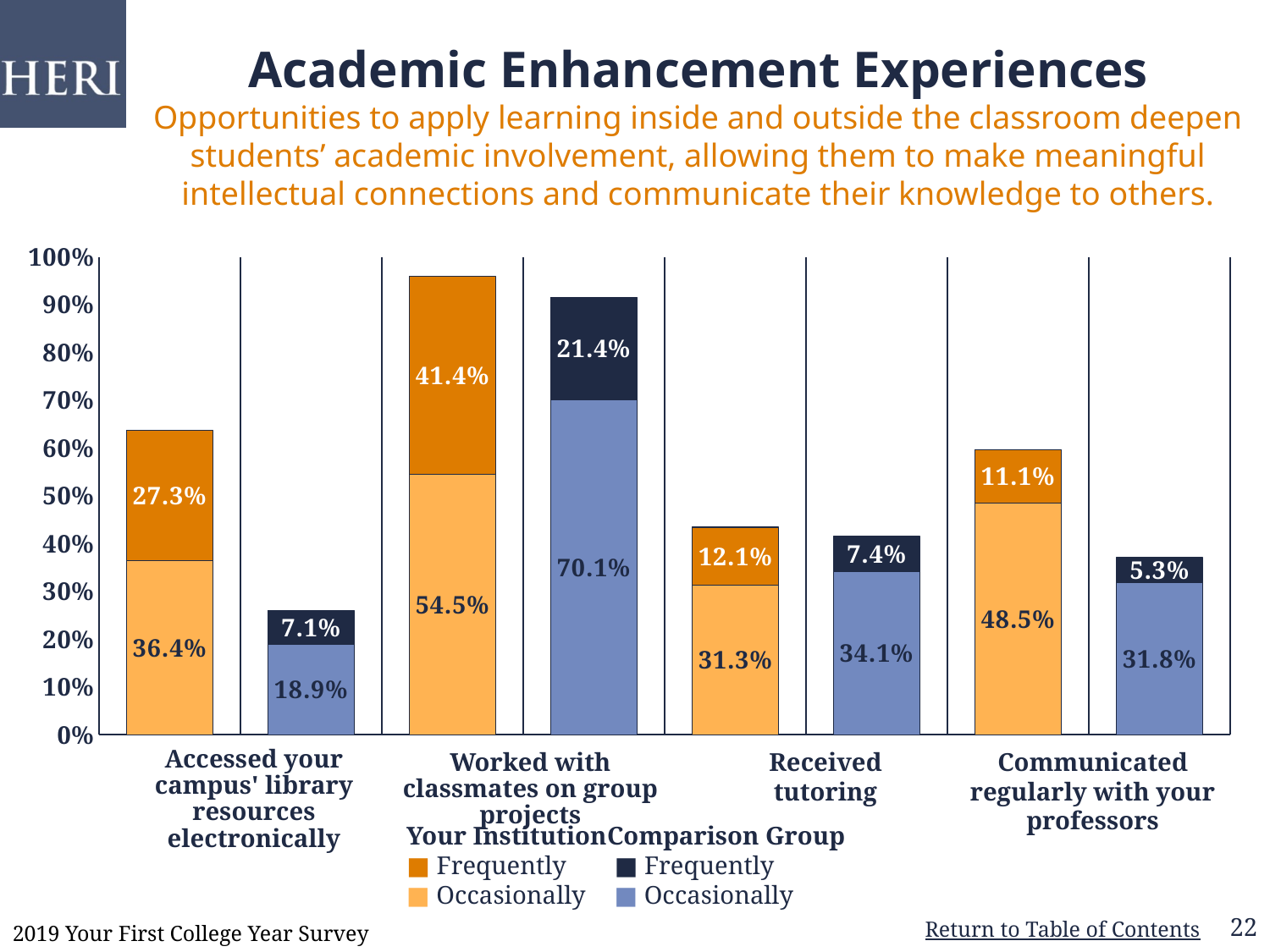
What percentage of students at Your Institution reported frequently accessing their campus' library resources electronically? 27.3% How many activity categories are shown on the x axis of the chart? 4 Which activity has the lowest 'Frequently' percentage for the Comparison Group? Communicated regularly with your professors What is the difference between the 'Frequently' percentages for Your Institution and the Comparison Group for accessing campus library resources electronically? 20.2% What is the total percentage of the Comparison Group who frequently or occasionally received tutoring? 41.5% What percentage of students at Your Institution reported occasionally communicating regularly with their professors? 48.5% For received tutoring, which group has the larger 'Occasionally' percentage, Your Institution or the Comparison Group? Comparison Group What is the total percentage of Your Institution students who frequently or occasionally worked with classmates on group projects? 95.9% How many series does the chart's legend list? 4 Which activity has the highest 'Frequently' percentage for Your Institution? Worked with classmates on group projects What type of chart is shown on the slide? Stacked bar chart What percentage of the Comparison Group reported occasionally working with classmates on group projects? 70.1%